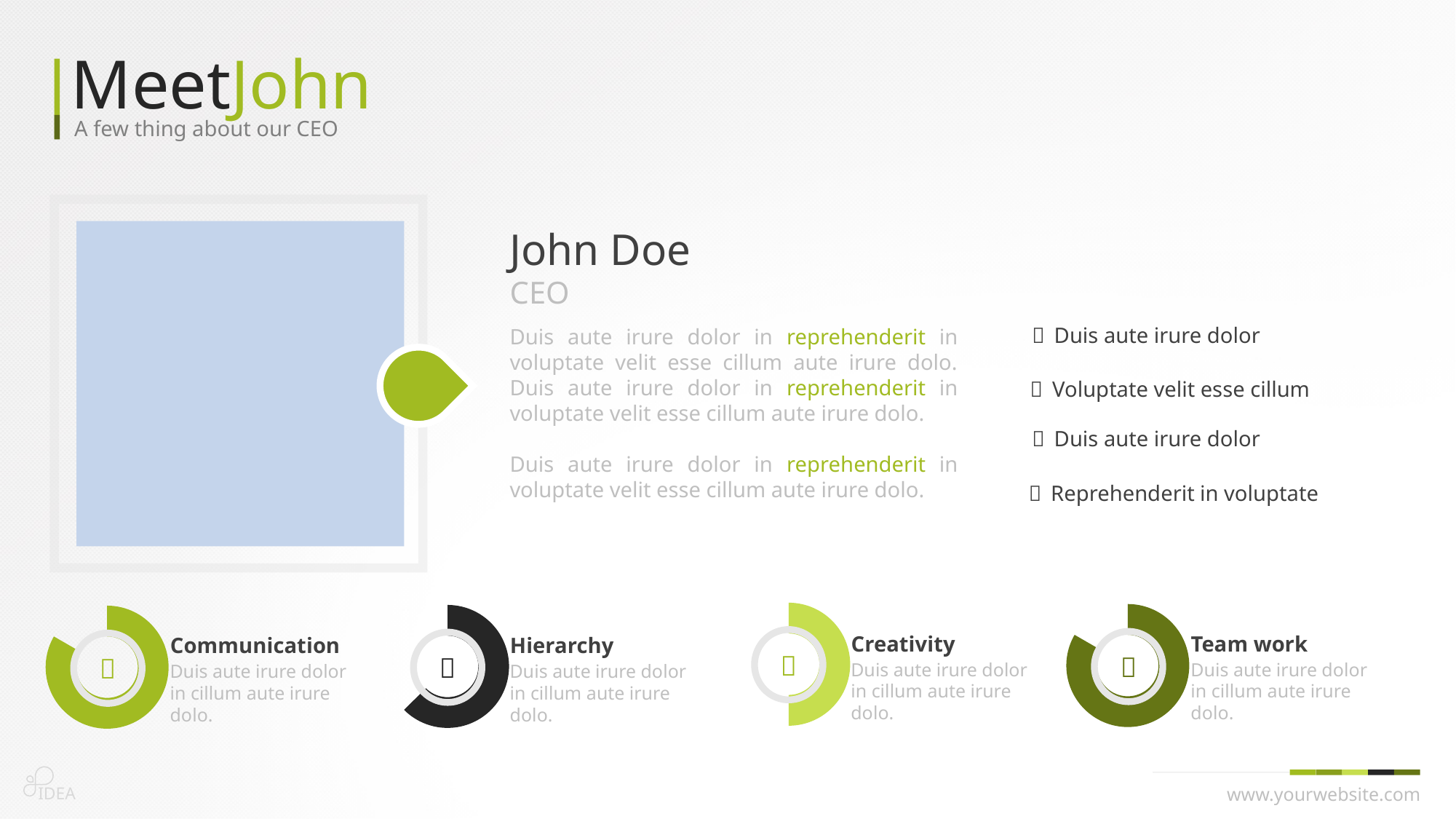
Which of the bottom doughnut charts has a larger filled portion, Team work or Creativity? Team work How many doughnut charts are shown at the bottom of the slide? 4 What kind of chart is used for the four skill indicators at the bottom of the slide? doughnut chart What is the label of the doughnut chart on the far right at the bottom of the slide? Team work Which doughnut chart at the bottom of the slide is drawn in black? Hierarchy What is the label of the first doughnut chart on the left at the bottom of the slide? Communication Which of the bottom doughnut charts has a larger filled portion, Communication or Hierarchy? Communication